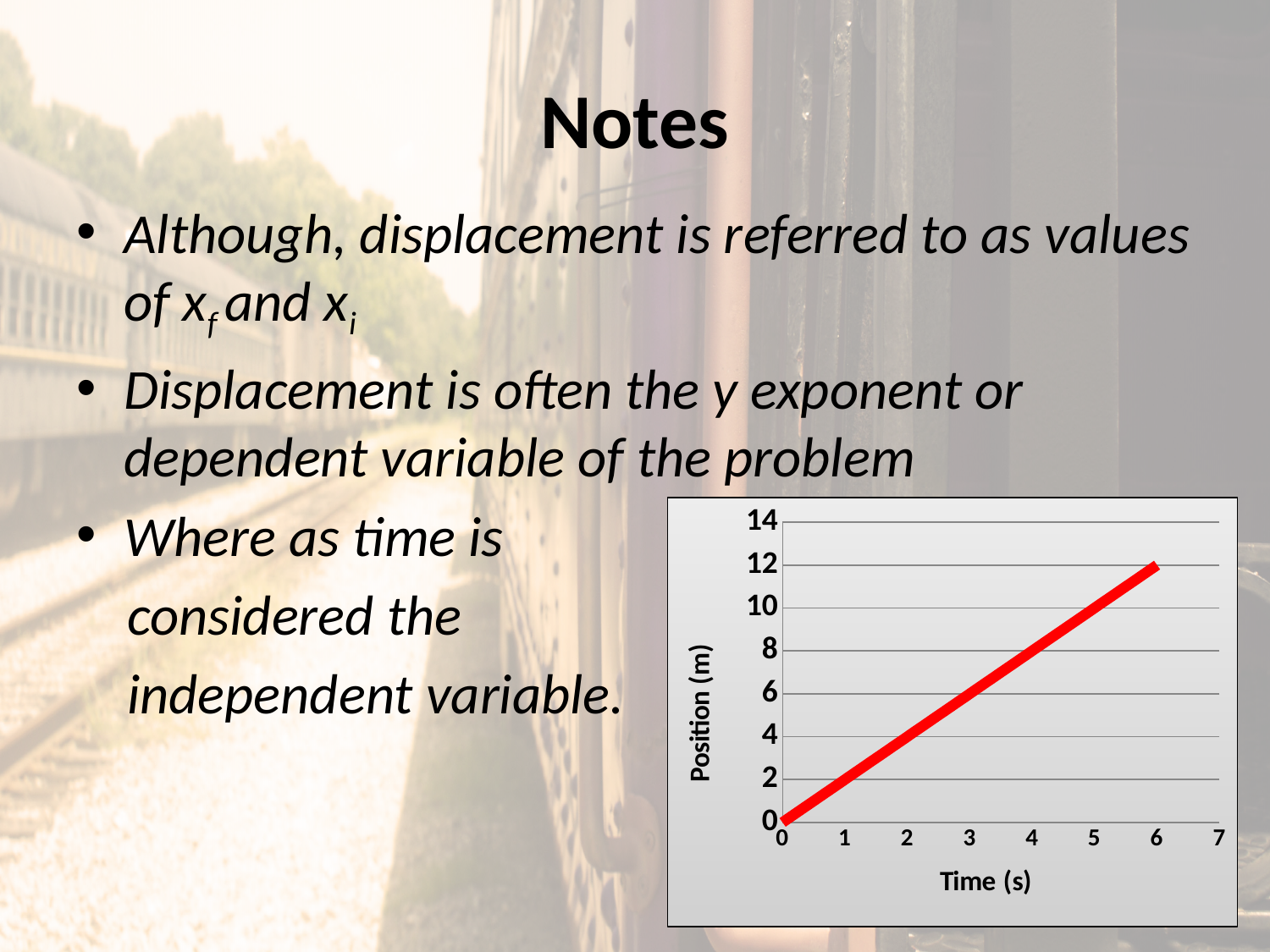
What is the label of the x axis of the chart? Time (s) What is the position at time 0 s, where the line starts? 0 Is the position at time 5 s greater or less than 8 m? greater What is the position at time 6 s, where the line ends? 12 Is the position at time 2 s greater or less than 6 m? less Does the position rise or fall as time increases along the x axis? rise Which is larger, the position at time 6 s or the position at time 2 s? time 6 s Is the position at time 1 s greater or less than 4 m? less What kind of chart is shown on the slide? line chart What is the highest value shown on the y axis of the chart? 14 What is the label of the y axis of the chart? Position (m)